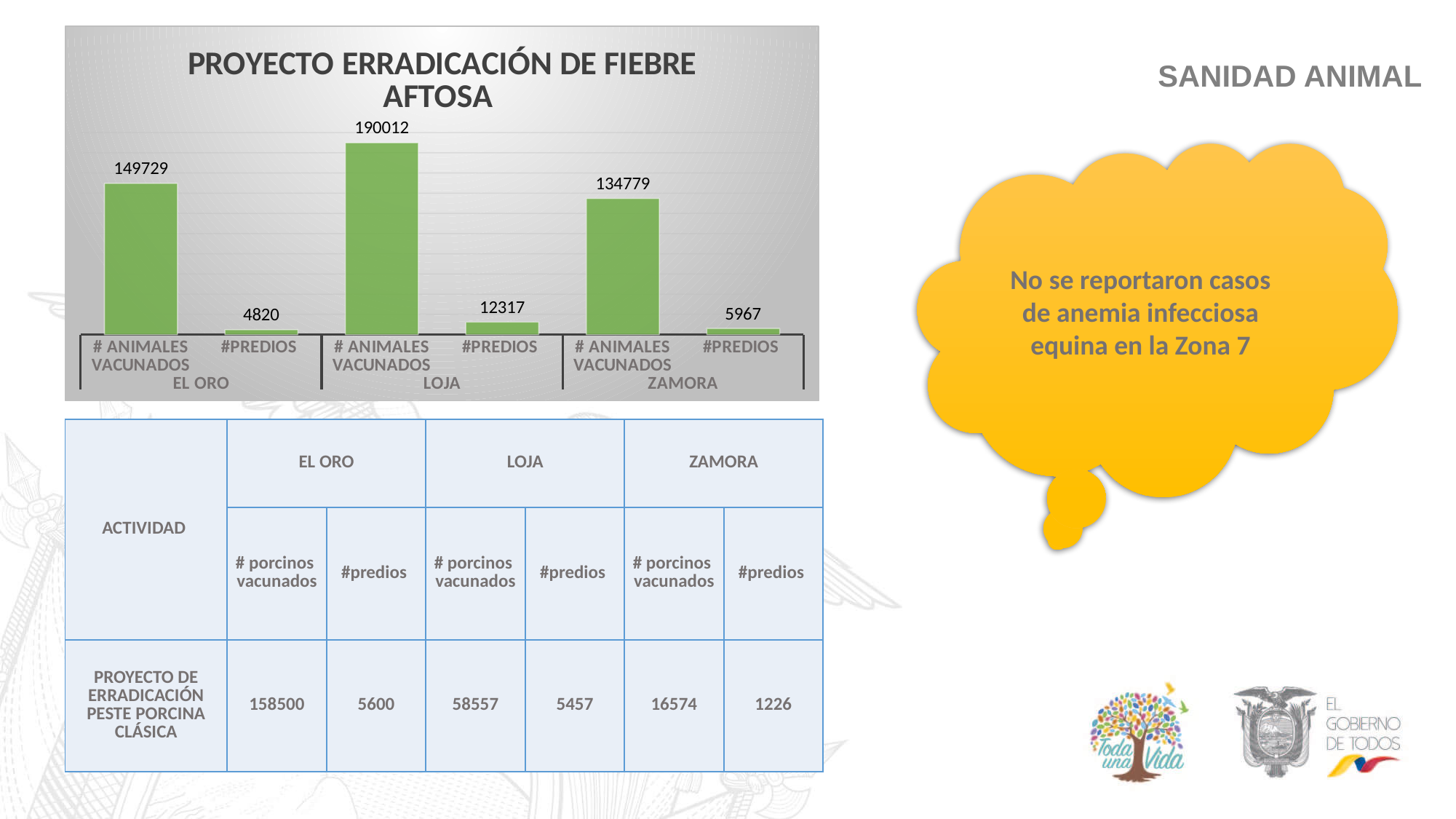
What is the value for # ANIMALES VACUNADOS in ZAMORA? 134779 What is the title of the chart? PROYECTO ERRADICACIÓN DE FIEBRE AFTOSA What is the difference between #PREDIOS in LOJA and in ZAMORA? 6350 Which is larger: # ANIMALES VACUNADOS in EL ORO or in ZAMORA? EL ORO What is the difference between # ANIMALES VACUNADOS in LOJA and in EL ORO? 40283 What is the value for # ANIMALES VACUNADOS in EL ORO? 149729 How many bars are plotted in the chart? 6 What is the value for #PREDIOS in EL ORO? 4820 Which province has the lowest value for #PREDIOS? EL ORO Which province has the highest value for # ANIMALES VACUNADOS? LOJA What kind of chart is shown on the slide? Bar chart What is the value for #PREDIOS in LOJA? 12317